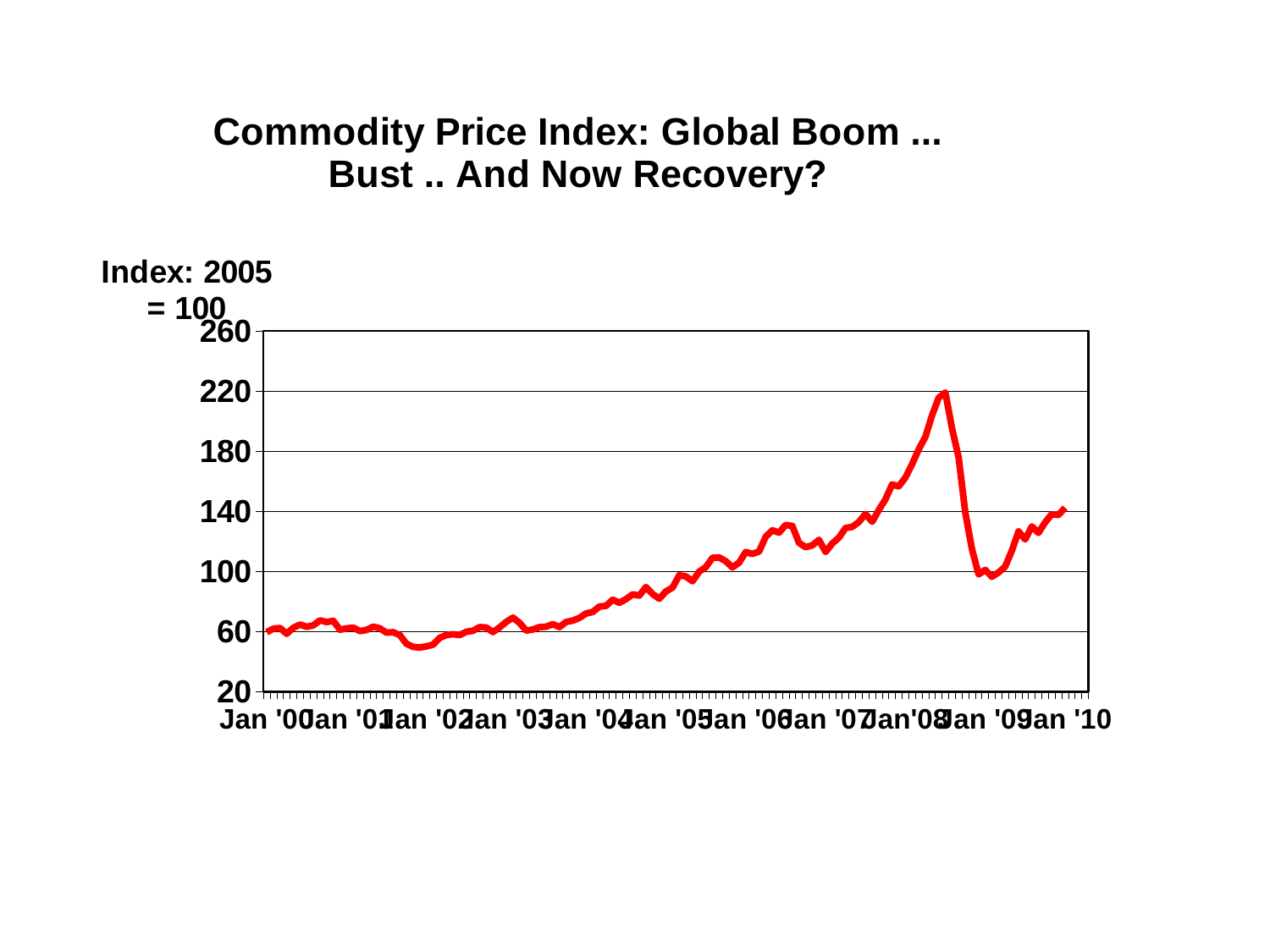
Is the value at Jan '04 greater or less than 100? less What is the title of the chart? Commodity Price Index: Global Boom ... Bust .. And Now Recovery? Is the value at Jan '06 greater or less than 100? greater Does the index rise or fall between Jan '02 and Jan '08? rise Is the value at Jan '02 greater or less than 60? less Which is larger, the value at Jan '08 or the value at Jan '09? Jan '08 In which year does the index reach its highest point? 2008 What kind of chart is shown on the slide? line chart What base year and value does the index use, according to the axis label? 2005 = 100